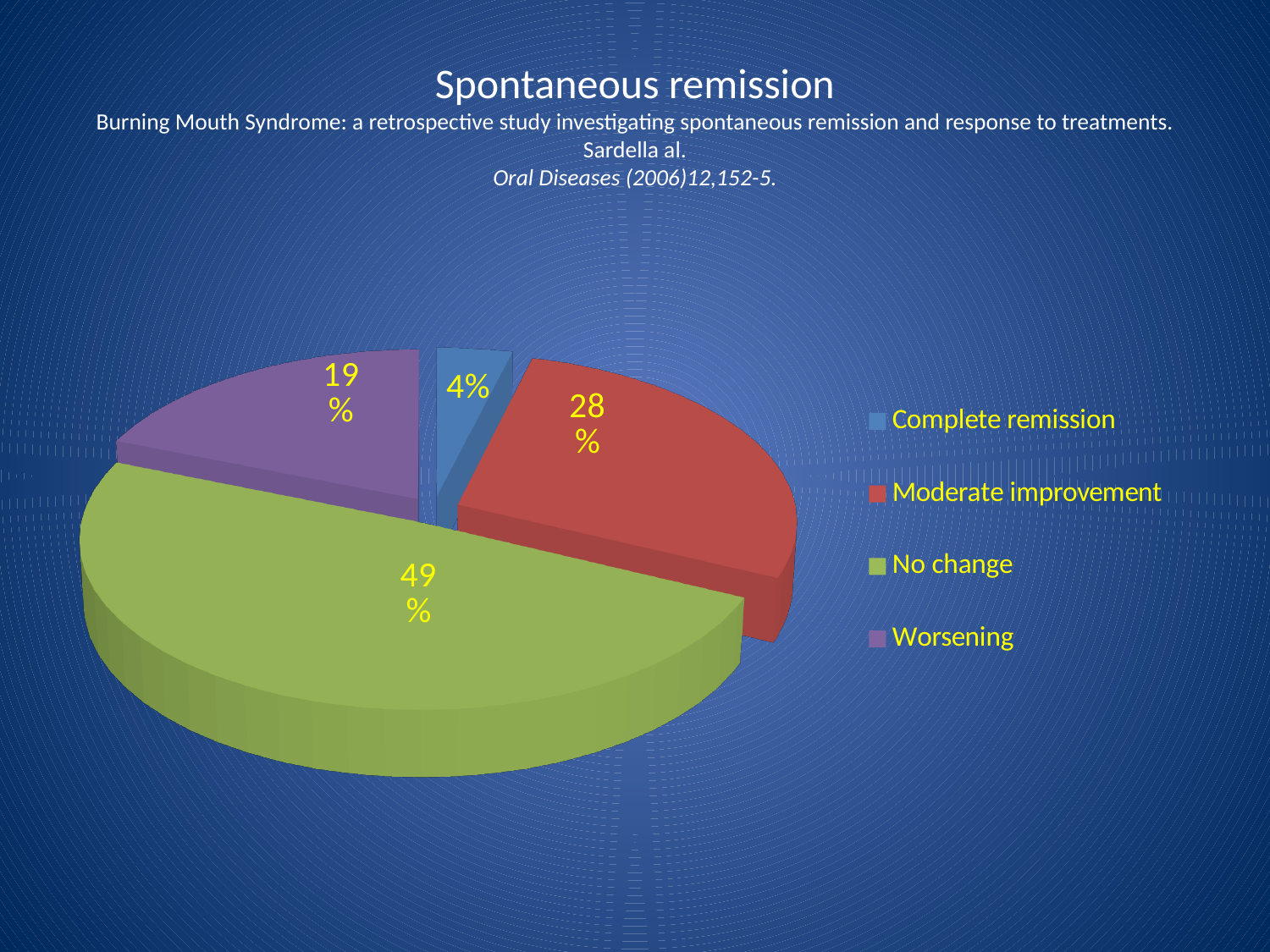
What is the difference in percentage points between No change and Moderate improvement? 21 What percentage of the pie is labelled for Moderate improvement? 28% What percentage of the pie is labelled for No change? 49% What is the difference in percentage points between Worsening and Complete remission? 15 What percentage of the pie is labelled for Complete remission? 4% Which category has the largest share of the pie? No change What colour is the slice for No change? Green What kind of chart is shown on the slide? Pie chart Which is larger, the share for Moderate improvement or the share for Worsening? Moderate improvement Which category has the smallest share of the pie? Complete remission What percentage of the pie is labelled for Worsening? 19% How many categories does the pie chart show? 4